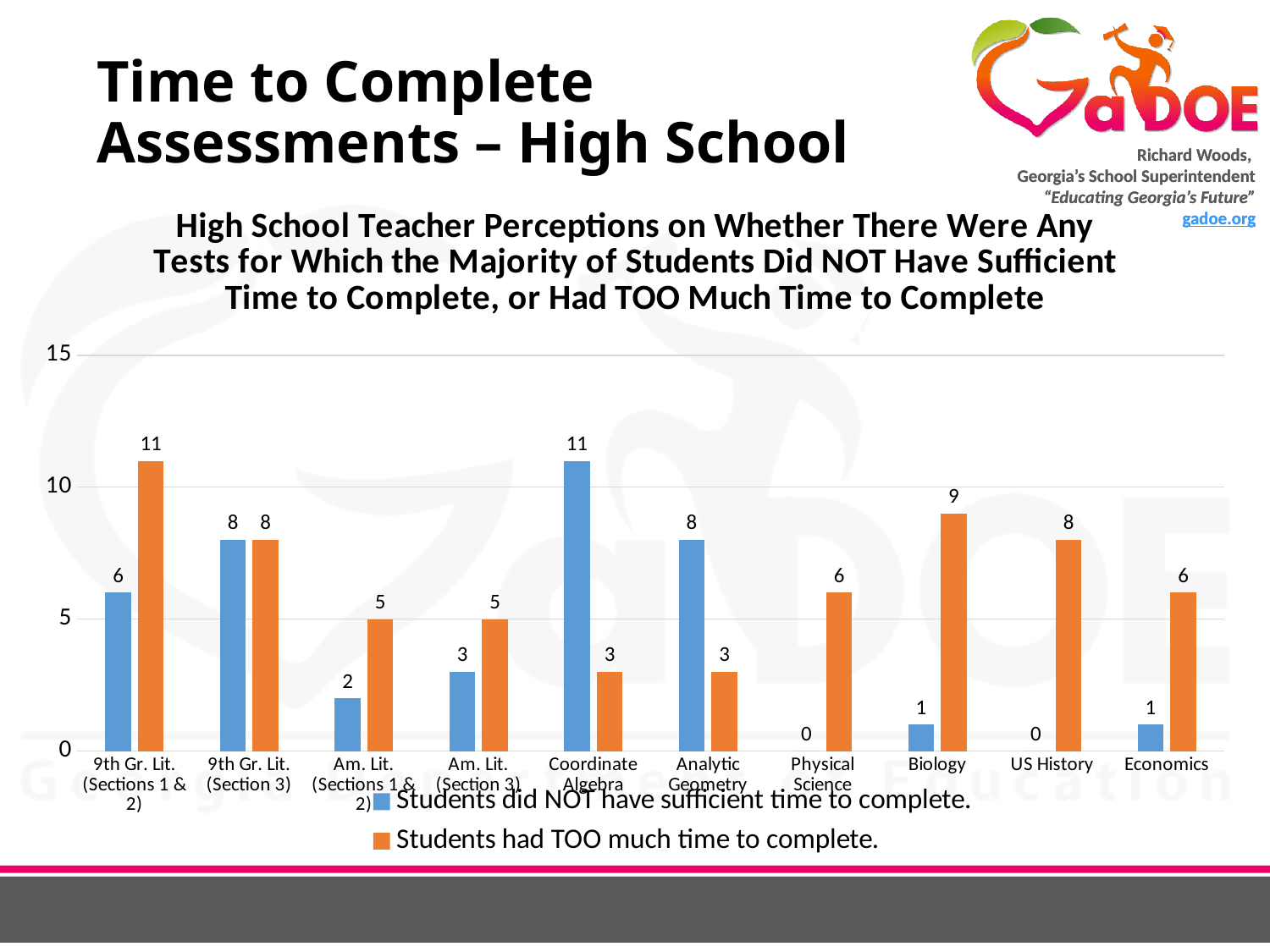
What kind of chart is shown on the slide? Bar chart What is the value for Biology in the 'Students had TOO much time to complete' series? 9 For Analytic Geometry, which series has the larger value: 'Students did NOT have sufficient time to complete' or 'Students had TOO much time to complete'? Students did NOT have sufficient time to complete What colour are the bars for the 'Students had TOO much time to complete' series? Orange Is the value for Physical Science in the 'Students had TOO much time to complete' series greater or less than 5? greater Which category has the highest value in the 'Students had TOO much time to complete' series? 9th Gr. Lit. (Sections 1 & 2) What is the value for US History in the 'Students did NOT have sufficient time to complete' series? 0 Which category has the highest value in the 'Students did NOT have sufficient time to complete' series? Coordinate Algebra How many series does the legend list? 2 What is the value for Coordinate Algebra in the 'Students did NOT have sufficient time to complete' series? 11 What is the difference between the 'Students had TOO much time to complete' value and the 'Students did NOT have sufficient time to complete' value for 9th Gr. Lit. (Sections 1 & 2)? 5 How many assessment categories are shown on the x axis? 10